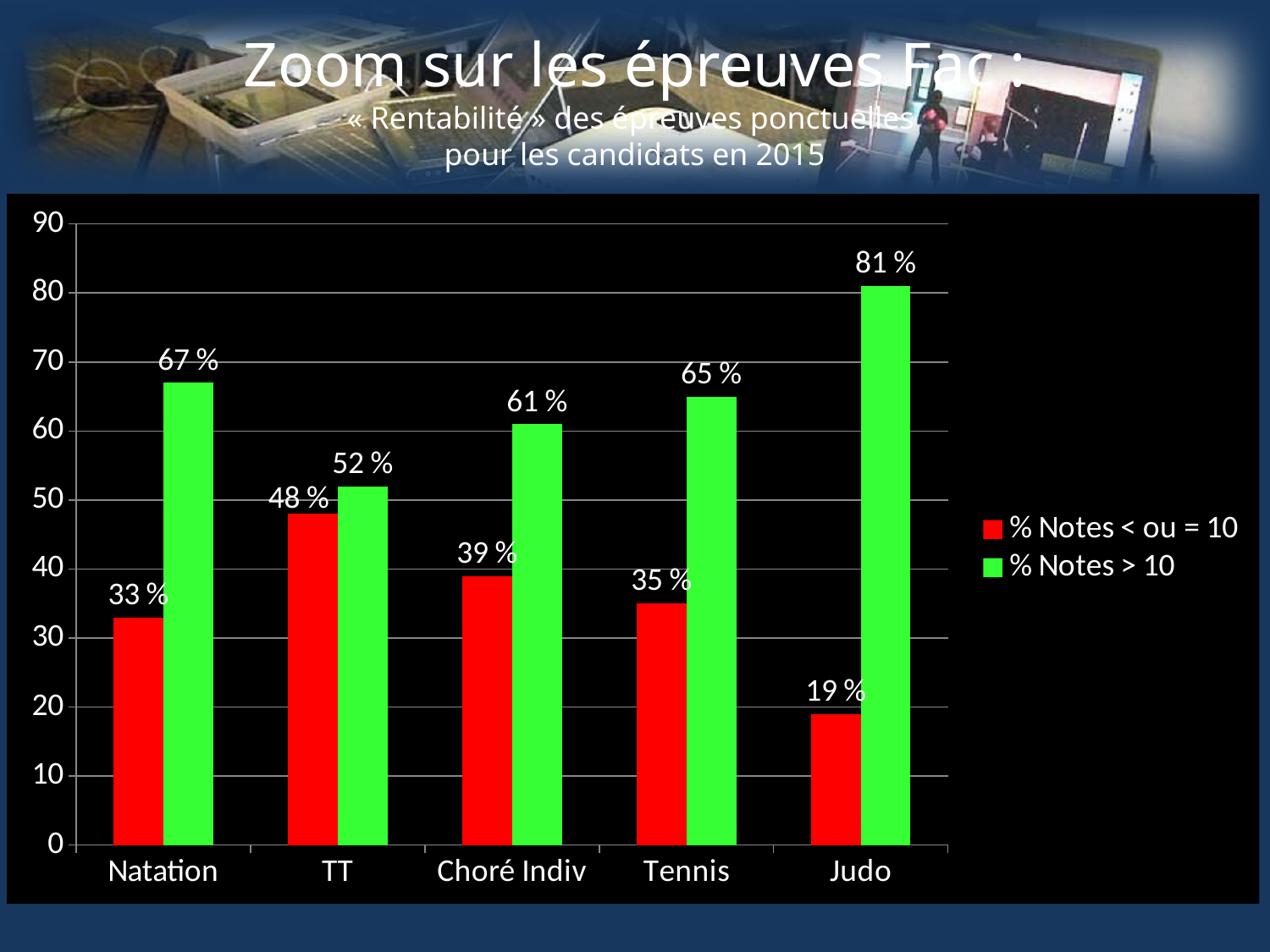
Which category has the lowest value for "% Notes < ou = 10"? Judo How many series does the legend list? 2 Which colour represents the series "% Notes > 10"? Green What is the difference between "% Notes > 10" and "% Notes < ou = 10" for Natation? 34 % What is the value of "% Notes < ou = 10" for TT? 48 % How many categories are shown on the x axis? 5 What is the value of "% Notes > 10" for Choré Indiv? 61 % Which category has the highest value for "% Notes > 10"? Judo Which is larger for Tennis: "% Notes < ou = 10" or "% Notes > 10"? % Notes > 10 What is the value of "% Notes < ou = 10" for Tennis? 35 % What kind of chart is shown on the slide? Bar chart What is the value of "% Notes > 10" for Judo? 81 %